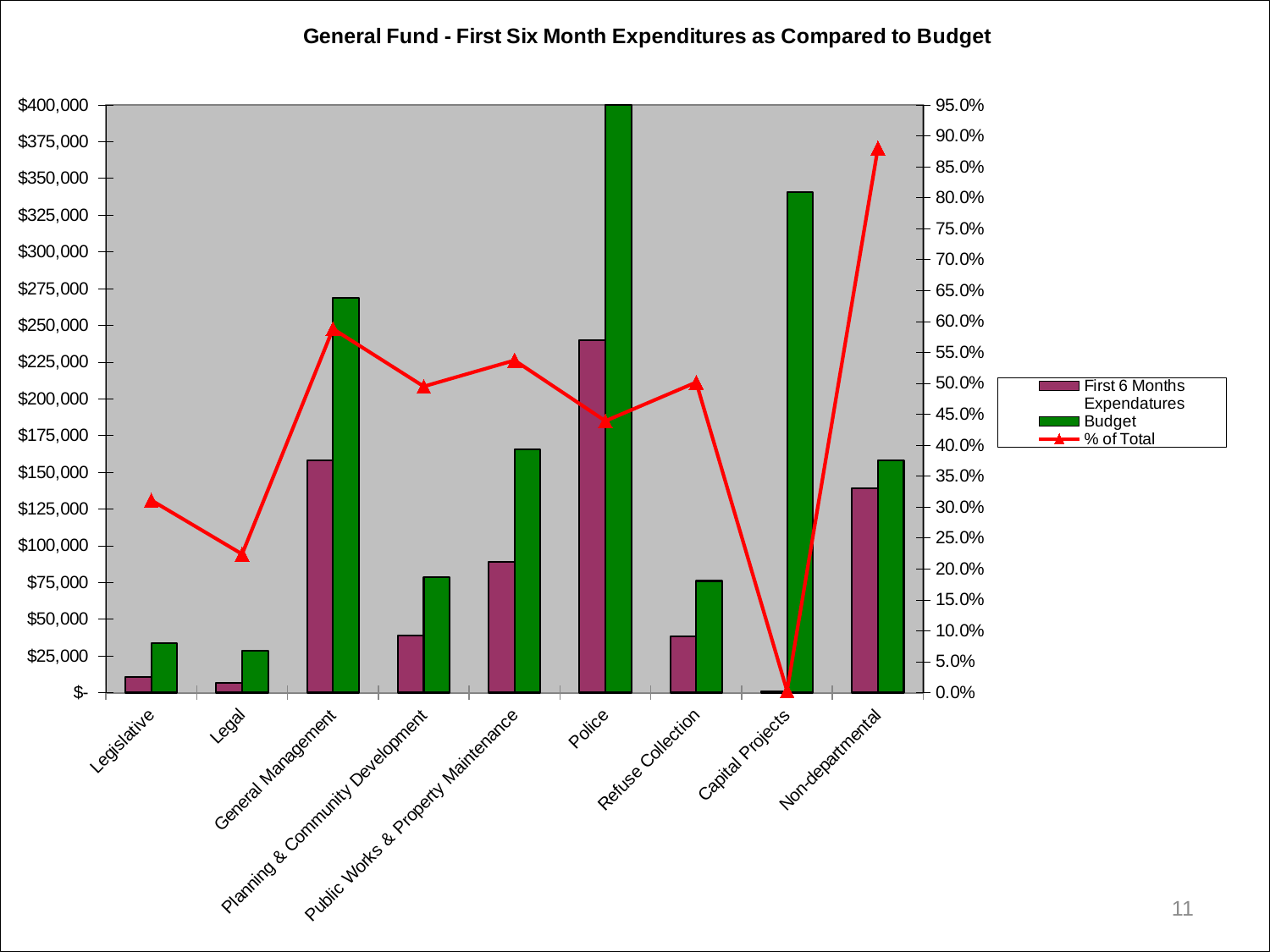
Which category has the highest Budget bar? Police How many categories are shown along the x axis? 9 What is the title of the chart? General Fund - First Six Month Expenditures as Compared to Budget What kind of chart is shown on the slide? A combined bar and line chart Is the Budget value for Capital Projects greater or less than $300,000? greater Which category has the highest % of Total value? Non-departmental Which is larger, the Budget for Capital Projects or the Budget for General Management? Capital Projects Is the First 6 Months Expendatures value for Legal greater or less than $25,000? less How many series does the legend list? 3 Which category has the lowest % of Total value? Capital Projects Is the First 6 Months Expendatures value for Police greater or less than $200,000? greater